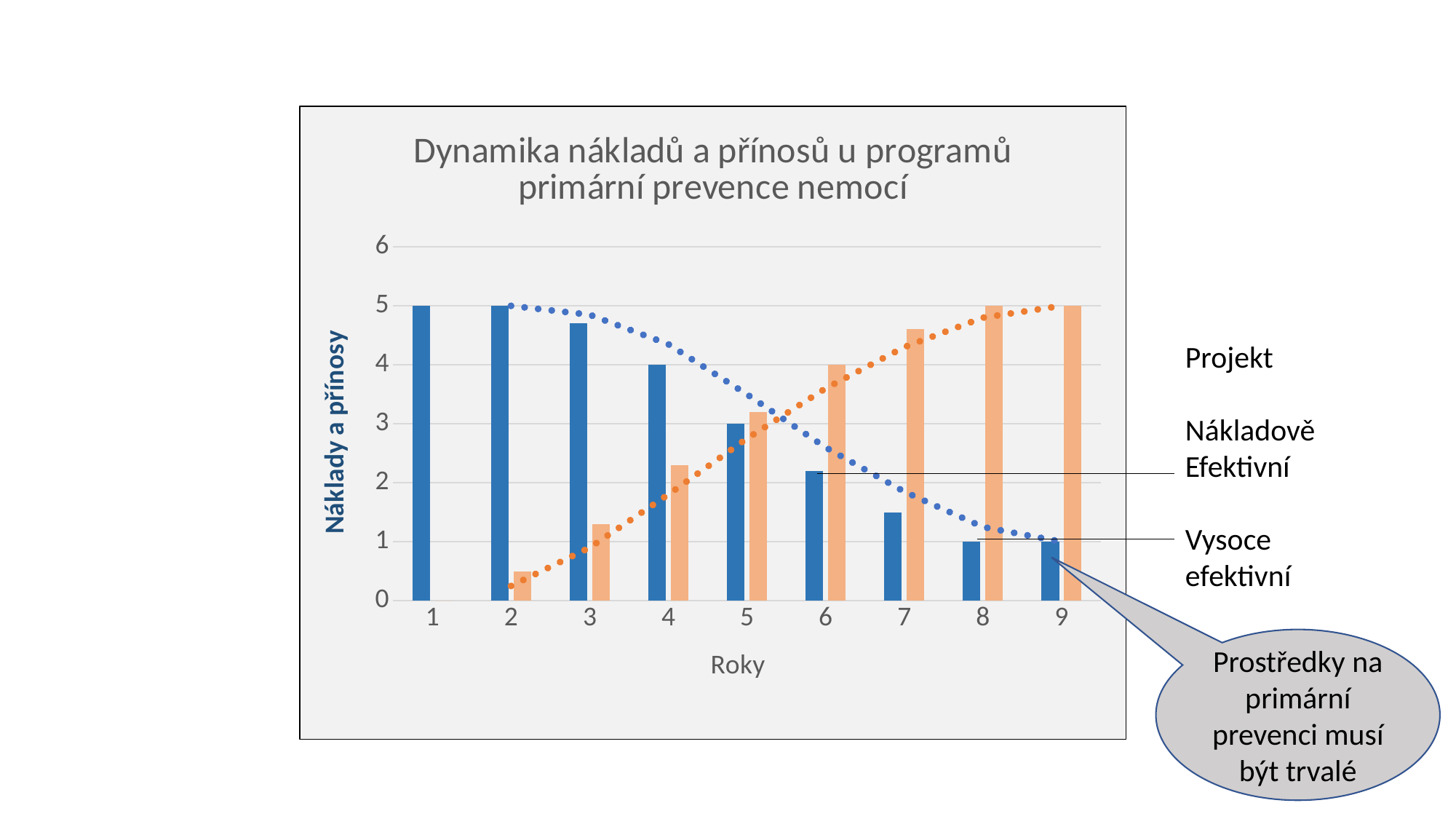
What is the label of the x axis? Roky How many years (categories) are shown on the x axis? 9 In year 7, which bar is larger, the blue one or the orange one? orange What is the value of the orange bar for year 9? 5 What is the value of the blue bar for year 4? 4 Do the orange bars rise or fall as the years increase? rise Is the value of the orange bar for year 3 greater or less than 2? less Is the value of the blue bar for year 3 greater or less than 4? greater What type of chart is shown on the slide? bar chart What is the value of the blue bar for year 1? 5 Do the blue bars rise or fall as the years increase? fall What is the title of the chart? Dynamika nákladů a přínosů u programů primární prevence nemocí